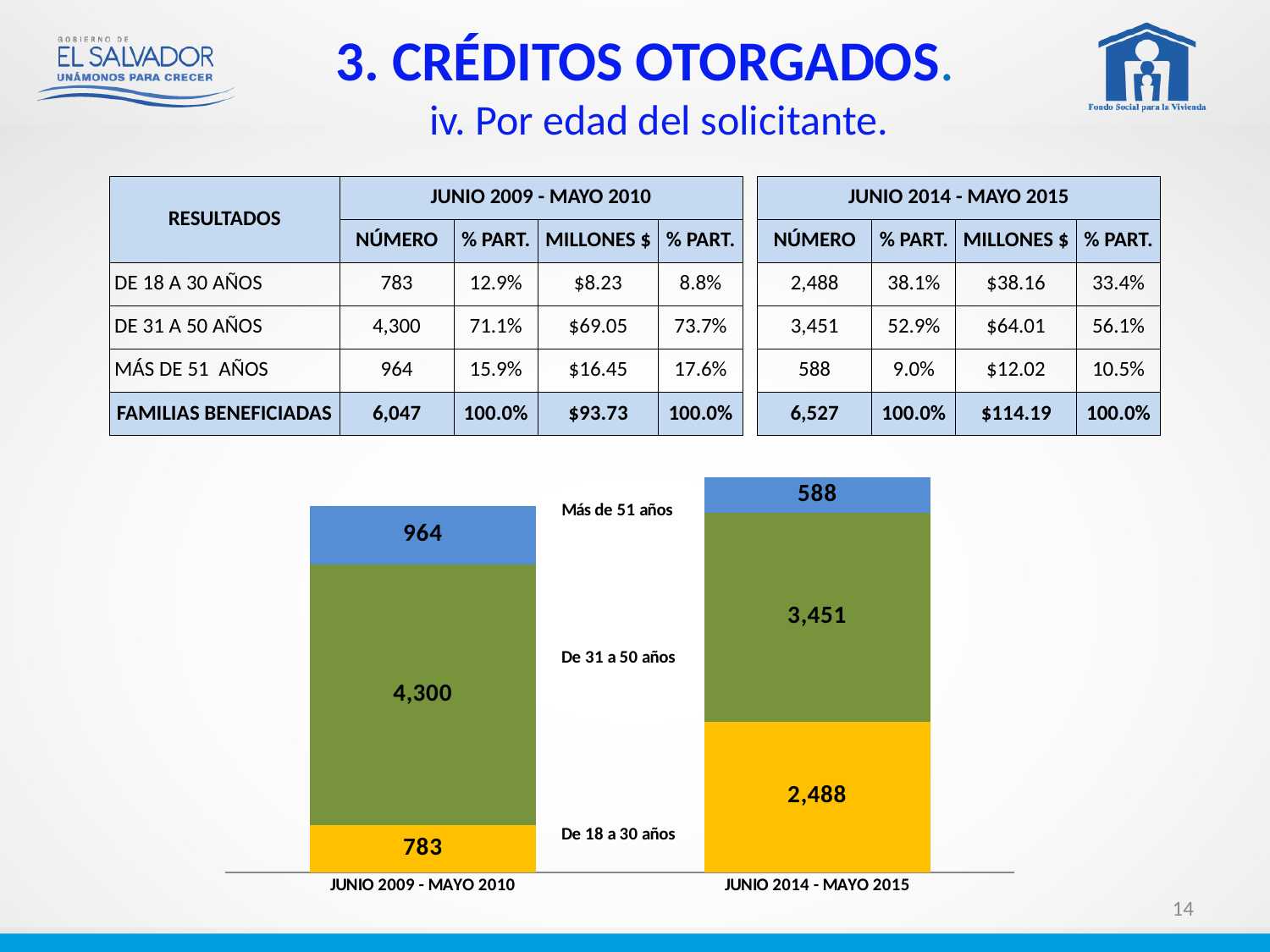
Which is larger: the De 31 a 50 años value for JUNIO 2009 - MAYO 2010 or for JUNIO 2014 - MAYO 2015? JUNIO 2009 - MAYO 2010 What is the total of the JUNIO 2009 - MAYO 2010 stacked bar? 6,047 What is the value for De 31 a 50 años in the JUNIO 2014 - MAYO 2015 bar? 3,451 What type of chart is shown on the slide? stacked bar chart Which age group has the largest segment in the JUNIO 2009 - MAYO 2010 bar? De 31 a 50 años What is the total of the JUNIO 2014 - MAYO 2015 stacked bar? 6,527 What is the difference between the De 18 a 30 años values for JUNIO 2014 - MAYO 2015 and JUNIO 2009 - MAYO 2010? 1,705 How many bars (periods) are shown on the x axis of the chart? 2 What is the value for Más de 51 años in the JUNIO 2009 - MAYO 2010 bar? 964 Which age group has the smallest segment in the JUNIO 2014 - MAYO 2015 bar? Más de 51 años What is the value for De 18 a 30 años in the JUNIO 2009 - MAYO 2010 bar? 783 What is the value for Más de 51 años in the JUNIO 2014 - MAYO 2015 bar? 588